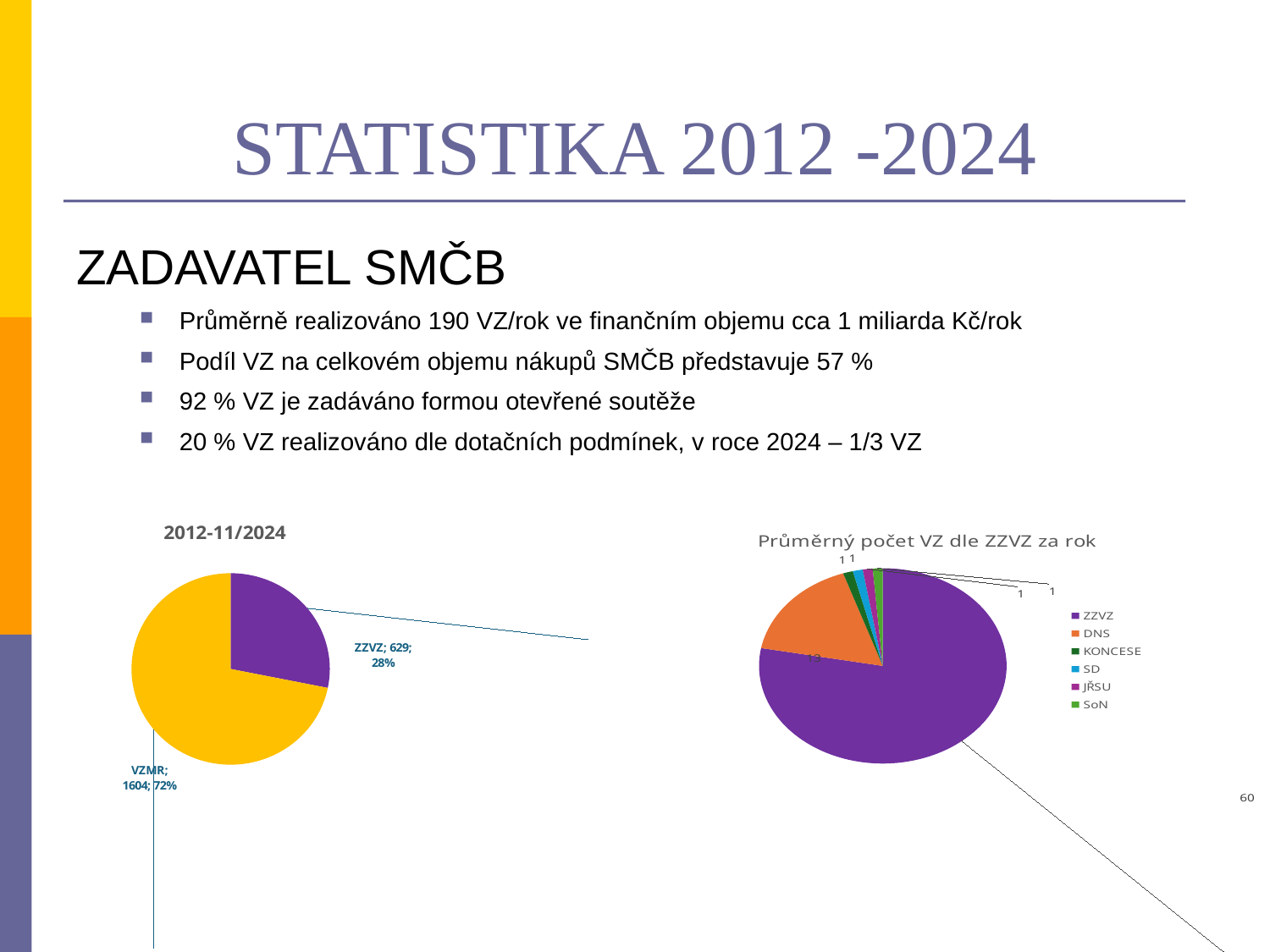
In the chart titled "2012-11/2024", what share of the pie does VZMR represent? 72% In the chart titled "2012-11/2024", what share of the pie does ZZVZ represent? 28% In the chart titled "2012-11/2024", what is the value for ZZVZ? 629 In the chart titled "2012-11/2024", what is the total of the two slices? 2233 In the chart titled "Průměrný počet VZ dle ZZVZ za rok", which category has the largest slice? ZZVZ In the chart titled "2012-11/2024", what is the difference between the VZMR value and the ZZVZ value? 975 What is the title of the pie chart on the right side of the slide? Průměrný počet VZ dle ZZVZ za rok How many entries does the legend of the chart titled "Průměrný počet VZ dle ZZVZ za rok" list? 6 How many slices does the chart titled "2012-11/2024" have? 2 In the chart titled "2012-11/2024", what is the value for VZMR? 1604 What kind of chart is the chart titled "2012-11/2024"? pie chart In the chart titled "2012-11/2024", which category has the largest slice? VZMR